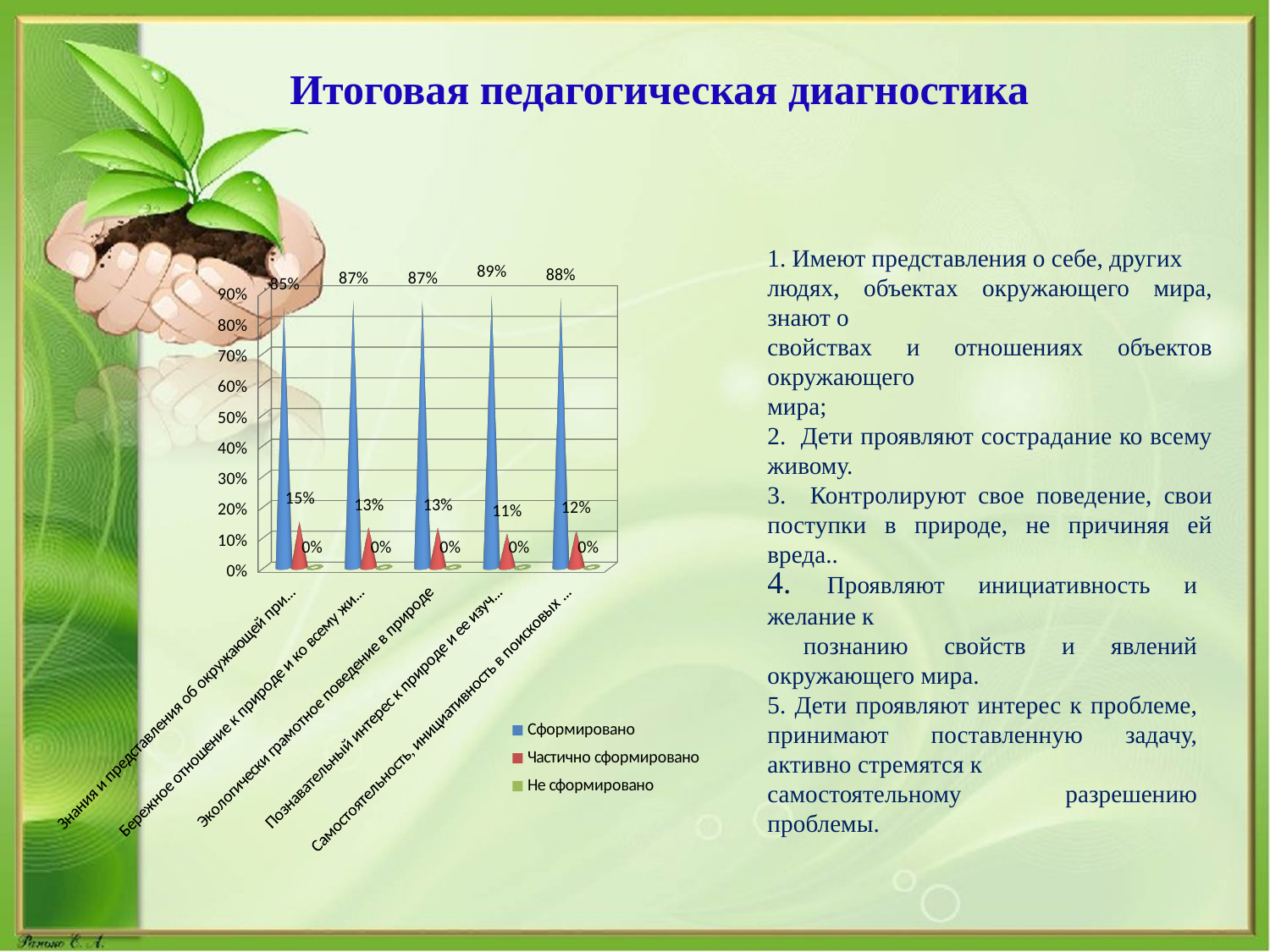
What is the value of "Сформировано" for the category "Экологически грамотное поведение в природе"? 87% What is the difference between the "Сформировано" values for the fourth category (89%) and the first category (85%)? 4% Which category has the lowest value for "Сформировано"? Знания и представления об окружающей при... What is the value of "Частично сформировано" for the first category ("Знания и представления об окружающей при...")? 15% What kind of chart is shown on the slide? bar chart How many series does the chart legend list? 3 What is the value of "Не сформировано" for the last category ("Самостоятельность, инициативность в поисковых ...")? 0% What is the value of "Сформировано" for the fourth category ("Познавательный интерес к природе и ее изуч...")? 89% Which series in the legend is shown in red? Частично сформировано Which is larger: the "Частично сформировано" value for the first category or for the fourth category? the first category (15%) How many categories are shown on the x axis of the chart? 5 Which category has the highest value for "Сформировано"? Познавательный интерес к природе и ее изуч...